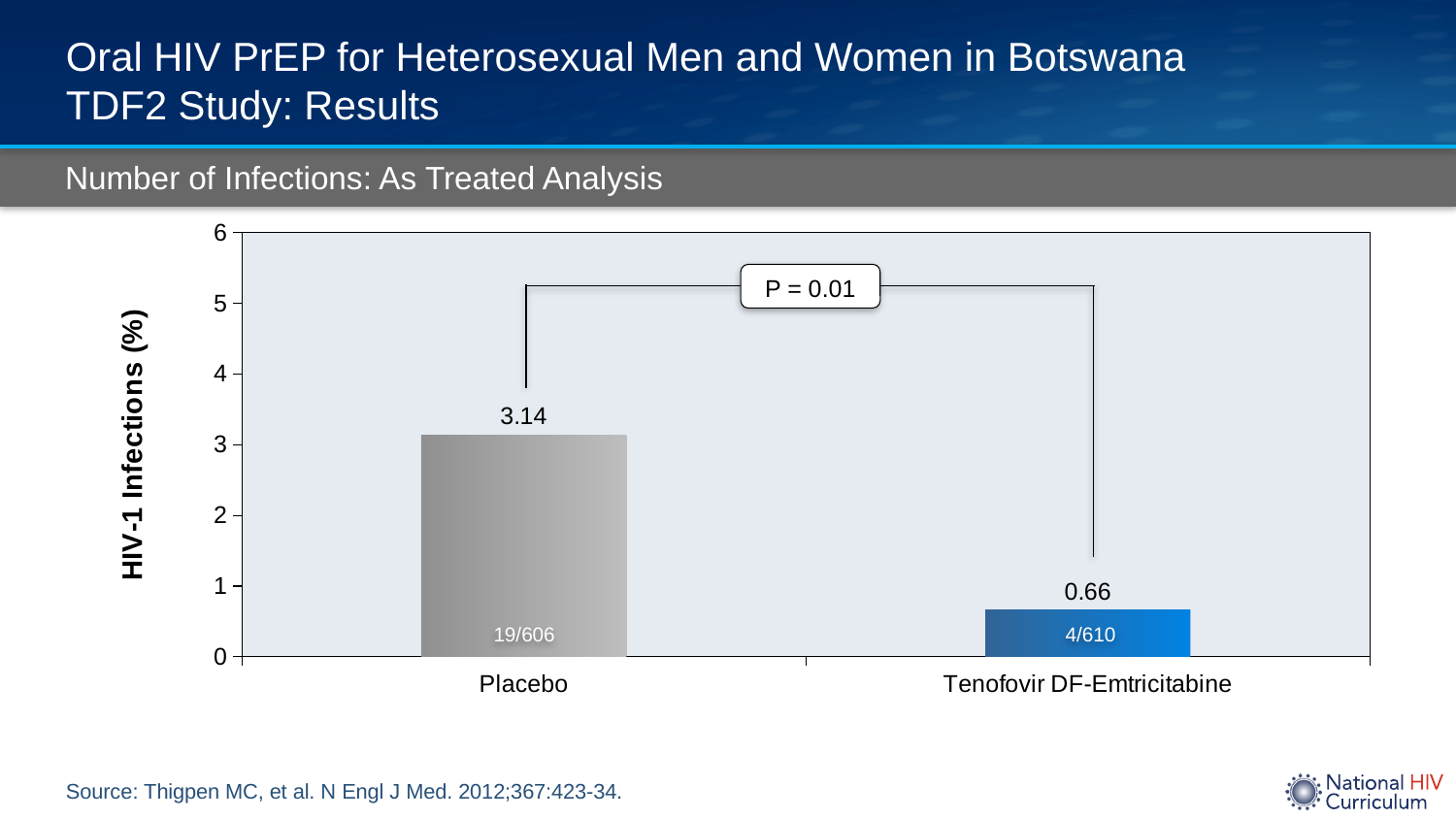
What kind of chart is shown on the slide? Bar chart What is the HIV-1 infection percentage for the Tenofovir DF-Emtricitabine group? 0.66 What P value is shown on the chart? P = 0.01 Is the value for Placebo greater or less than 3? greater Which group has the lower HIV-1 infection percentage? Tenofovir DF-Emtricitabine How many infections out of how many participants are shown for the Placebo bar? 19/606 How many groups are shown on the chart? 2 What is the HIV-1 infection percentage for the Placebo group? 3.14 How many infections out of how many participants are shown for the Tenofovir DF-Emtricitabine bar? 4/610 What is the difference in HIV-1 infection percentage between Placebo and Tenofovir DF-Emtricitabine? 2.48 Which group has the higher HIV-1 infection percentage? Placebo Is the value for Tenofovir DF-Emtricitabine greater or less than 1? less